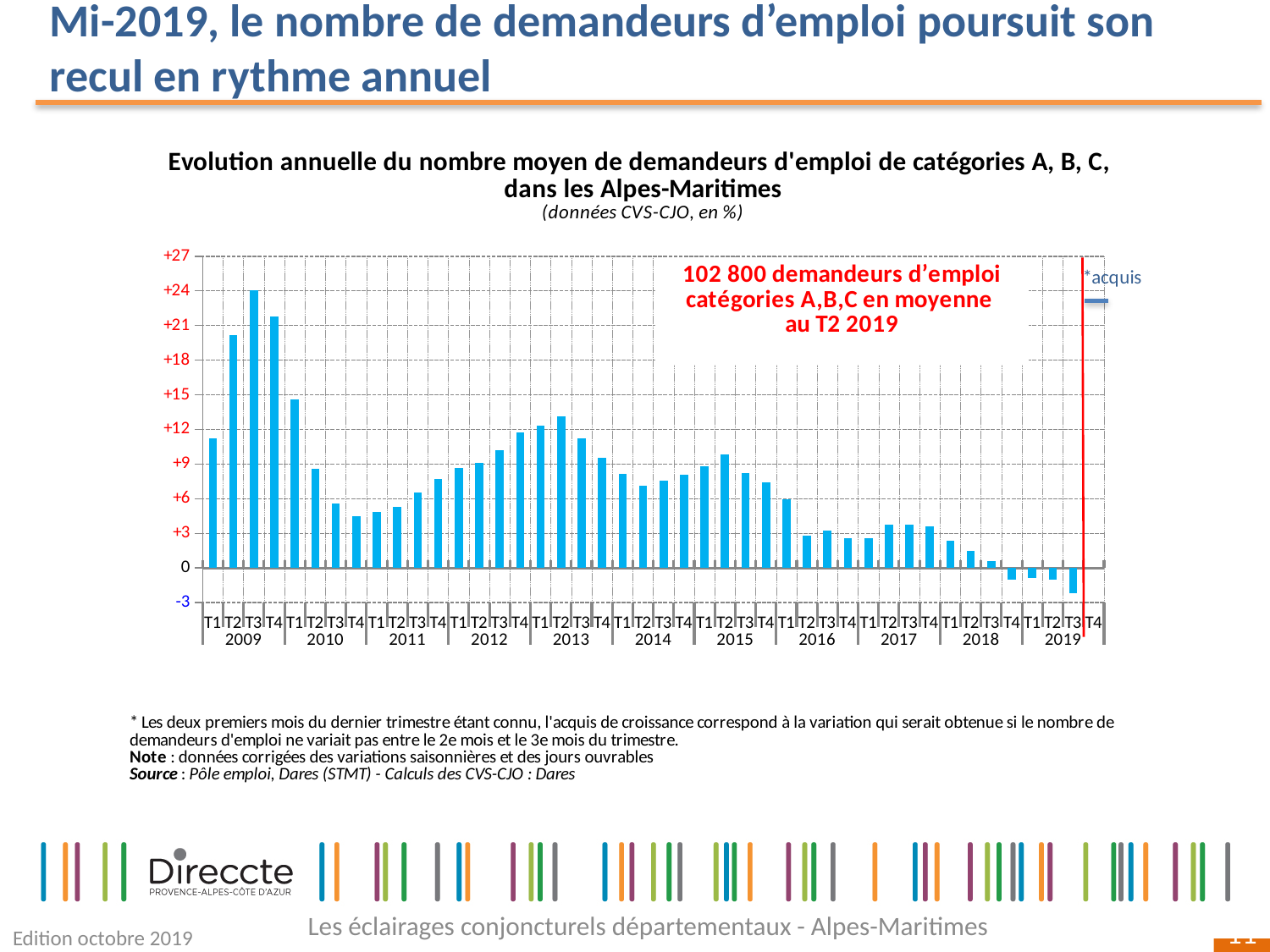
According to the annotation on the chart, how many demandeurs d'emploi catégories A,B,C were there on average in T2 2019? 102 800 Which quarter has the highest value in the chart? T3 2009 Which quarter has the lowest value in the chart? T3 2019 Is the value for T4 2010 greater or less than +6? less What kind of chart is shown on the slide? bar chart Is the value for T3 2019 greater or less than 0? less Is the value for T1 2010 greater or less than +12? greater Which is larger, the value for T1 2010 or the value for T1 2011? T1 2010 Overall, do the values rise or fall from 2009 to 2019? fall